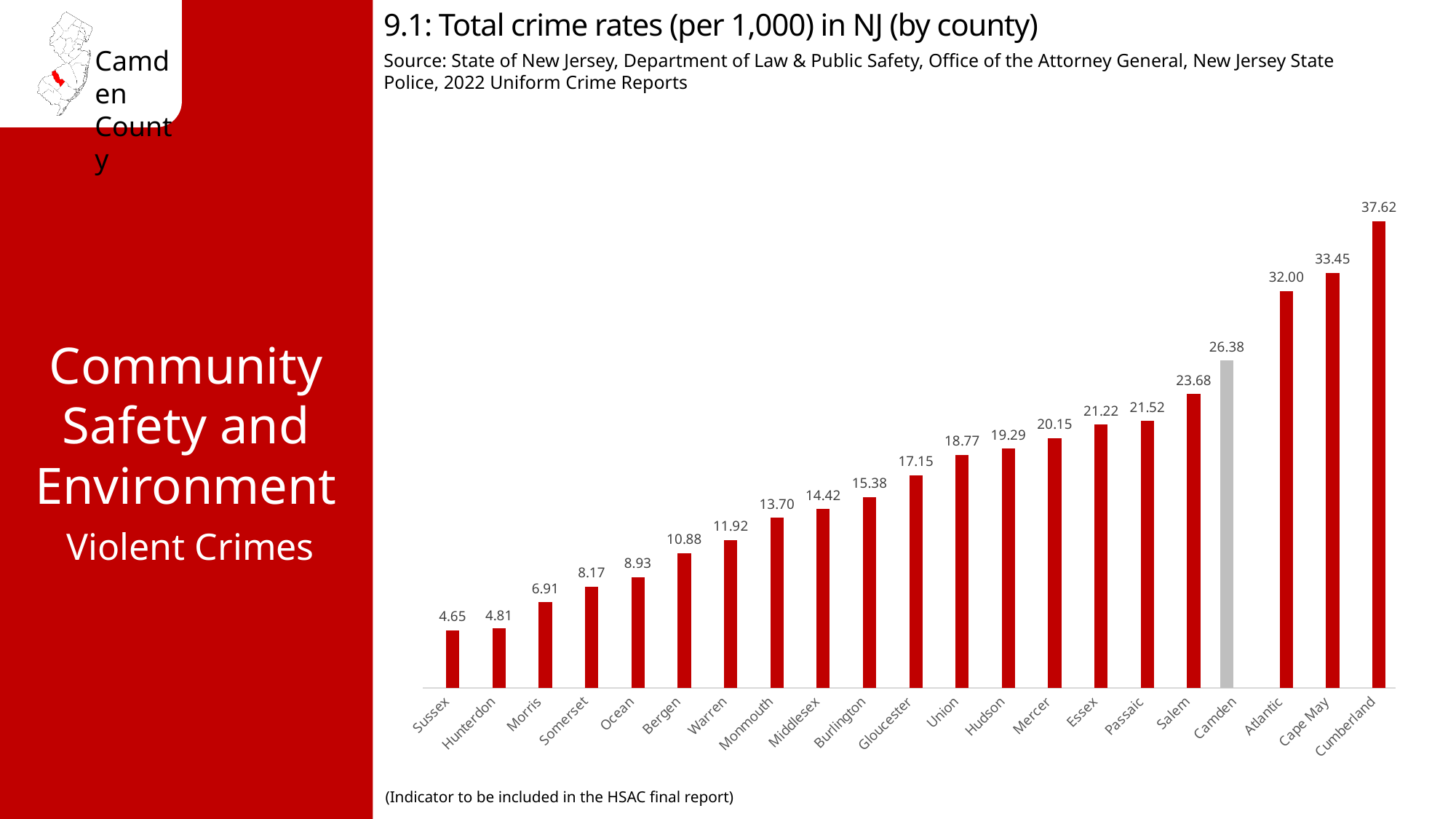
What is the difference between the total crime rates of Camden and Sussex? 21.73 What is the total crime rate (per 1,000) for Bergen County? 10.88 What is the total crime rate (per 1,000) for Cape May County? 33.45 What type of chart is used to show the total crime rates? Bar chart Which county's bar is coloured grey instead of red? Camden What is the total crime rate (per 1,000) for Camden County? 26.38 Do the values rise or fall moving from left to right along the x axis? Rise Which county has a higher total crime rate, Atlantic or Salem? Atlantic Which county has the highest total crime rate? Cumberland How many counties are shown in the chart? 21 Which county has the lowest total crime rate? Sussex What is the difference between the total crime rates of Cumberland and Camden? 11.24